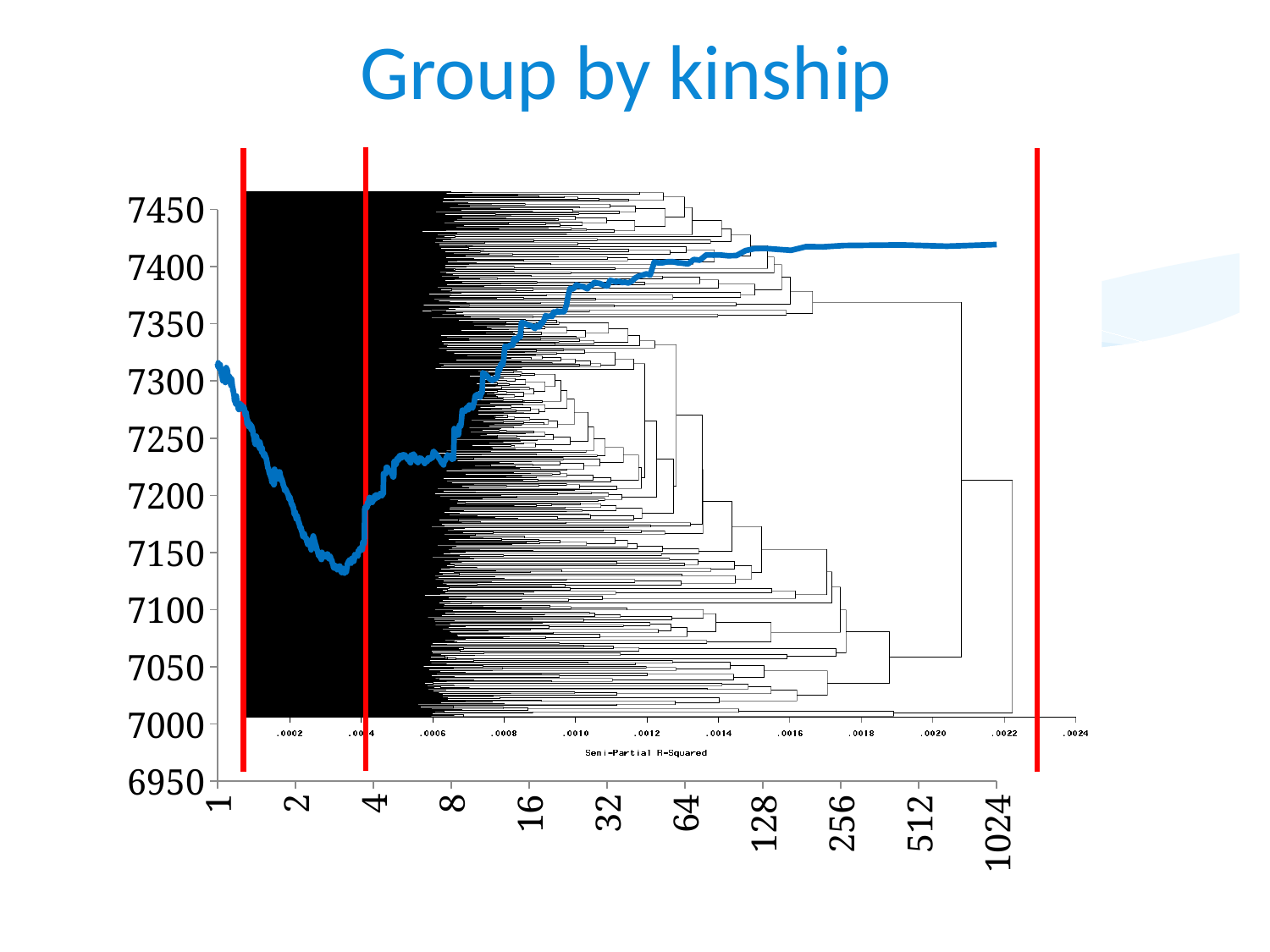
Is the value of the blue line at x = 1024 greater or less than 7400? greater Is the lowest point of the blue line greater or less than 7150? less Is the value of the blue line at x = 64 greater or less than 7350? greater What kind of chart is the blue series on the slide? line chart How many red vertical lines are drawn over the chart? 3 Does the blue line rise or fall between x = 1 and x = 3? falls Is the value of the blue line at x = 1024 larger or smaller than its value at x = 1? larger Is the value of the blue line at x = 8 larger or smaller than its value at x = 128? smaller What is the title of the chart on the slide? Group by kinship Does the blue line rise or fall between x = 4 and x = 1024? rises